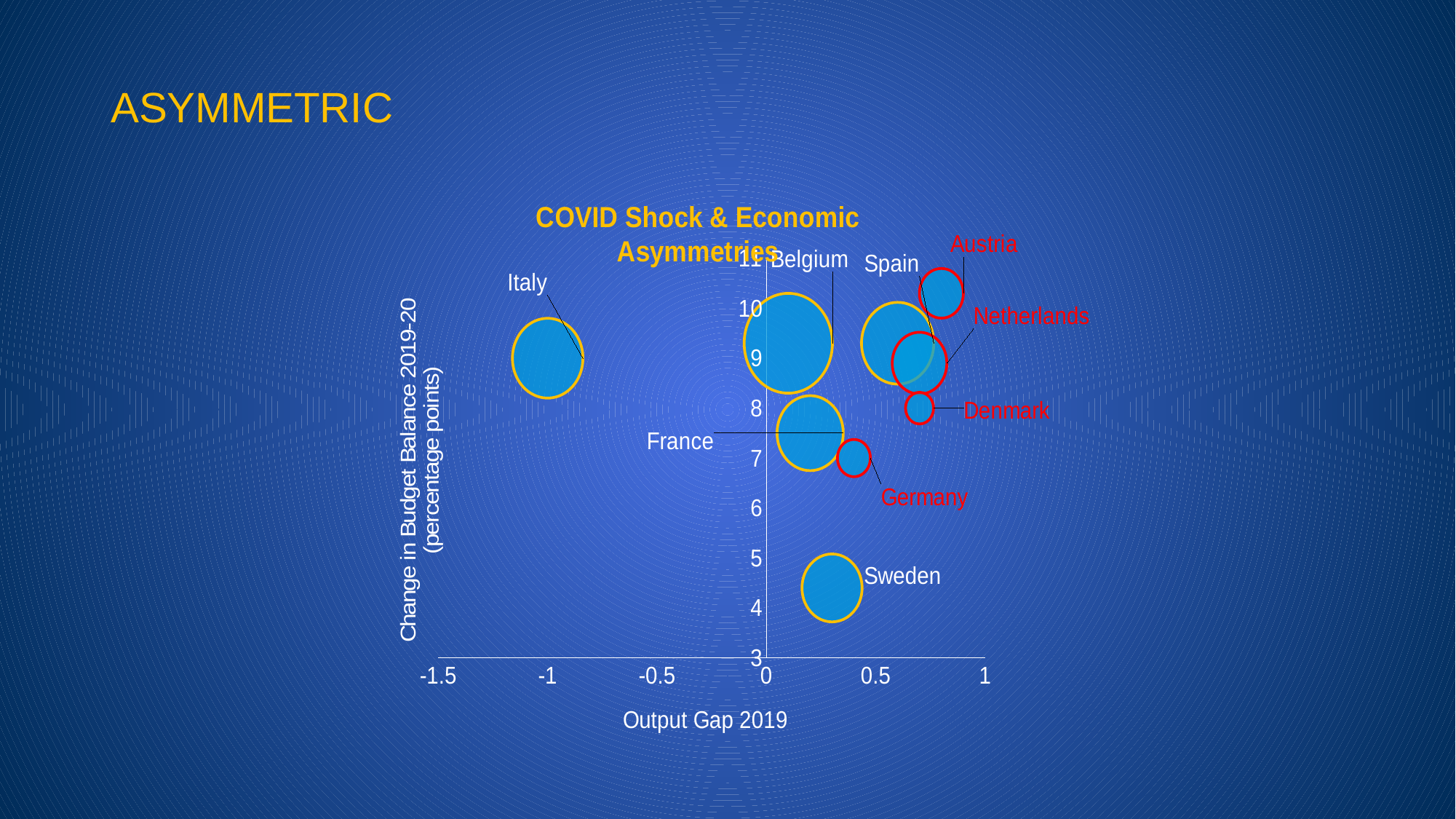
Is the change in budget balance for Sweden greater or less than 5? less What is the title of the chart? COVID Shock & Economic Asymmetries Is the output gap 2019 for Netherlands greater or less than 0.5? greater Which has the larger change in budget balance 2019-20, Italy or Sweden? Italy Is the output gap 2019 for Italy greater or less than 0? less Which country has the lowest output gap 2019 on the chart? Italy What kind of chart is shown on the slide? bubble chart Which country has the lowest change in budget balance 2019-20 on the chart? Sweden What is the label of the x axis of the chart? Output Gap 2019 How many countries are plotted on the chart? 9 Which country has the highest change in budget balance 2019-20 on the chart? Austria